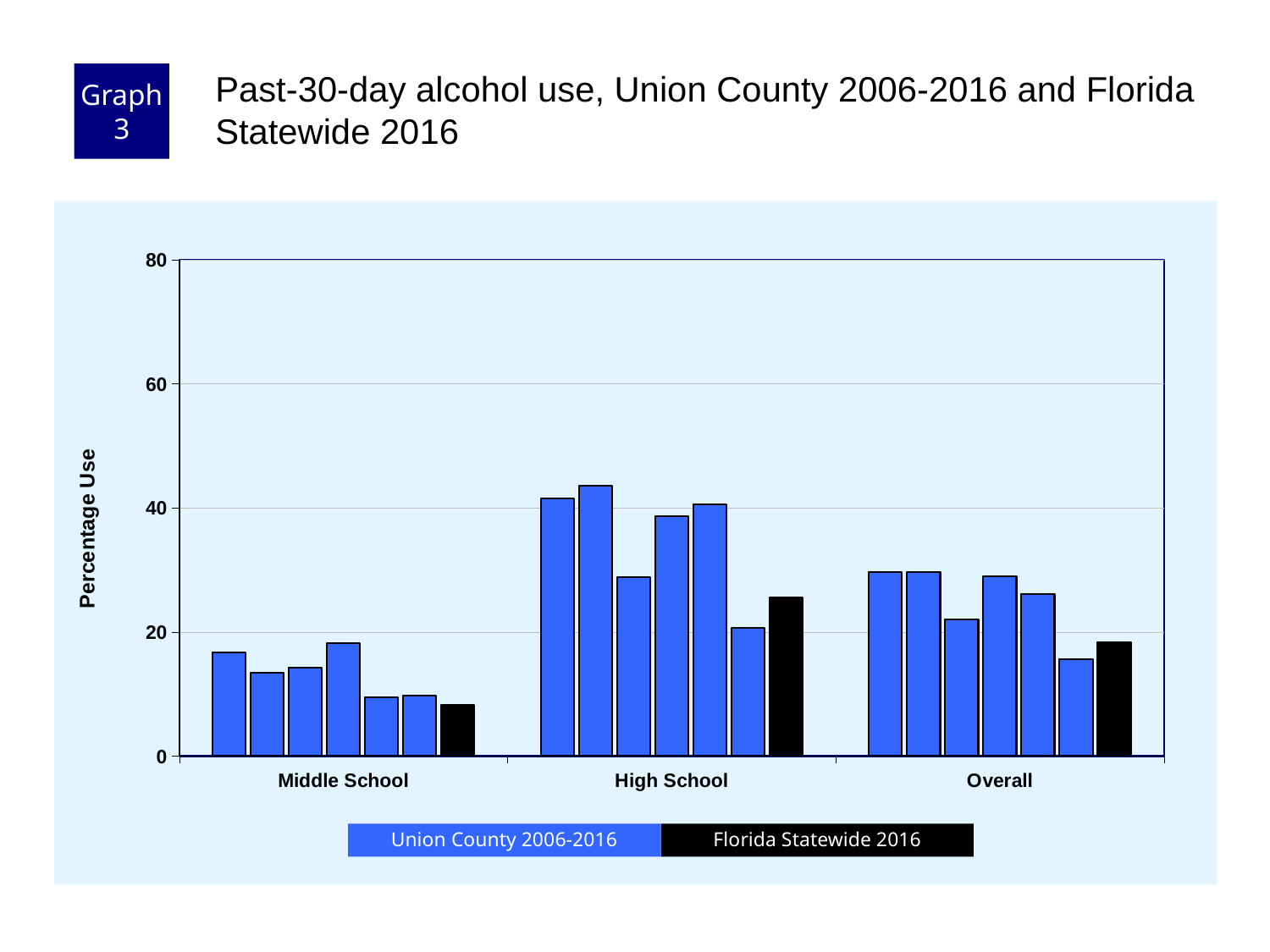
Which series is shown in black in the legend? Florida Statewide 2016 Is the Florida Statewide 2016 value for Middle School greater or less than 20? less Is the Florida Statewide 2016 value for High School greater or less than 40? less How many categories are shown on the x axis? 3 Which category has the highest Florida Statewide 2016 value? High School What kind of chart is shown on the slide? bar chart How many series does the legend list? 2 Which is larger, the Florida Statewide 2016 value for High School or for Middle School? High School Is the Florida Statewide 2016 value for High School greater or less than 20? greater Which category has the lowest Florida Statewide 2016 value? Middle School What is the label on the y axis? Percentage Use